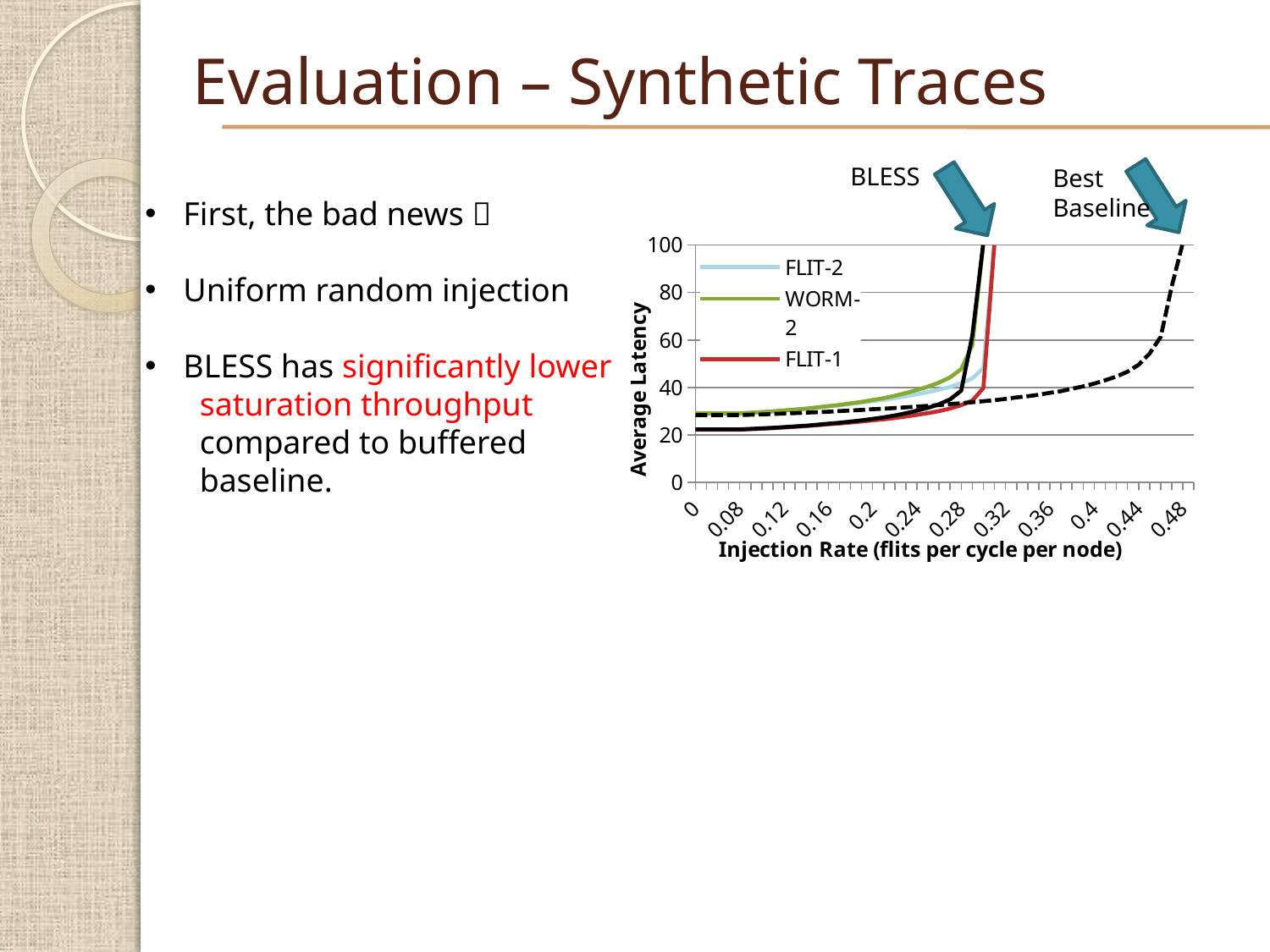
How many series does the chart's legend list? 3 At injection rate 0.08, which is larger, the value for WORM-2 or the value for FLIT-1? WORM-2 What is the title of the chart's y axis? Average Latency Is the value for FLIT-1 at injection rate 0 greater or less than 40? less What is the highest value shown on the y axis of the chart? 100 What kind of chart is shown on the slide? line chart What is the title of the chart's x axis? Injection Rate (flits per cycle per node) Is the value for FLIT-2 at injection rate 0.12 greater or less than 60? less Is the value for WORM-2 at injection rate 0.2 greater or less than 60? less Does the average latency rise or fall as the injection rate increases along the x axis? rise